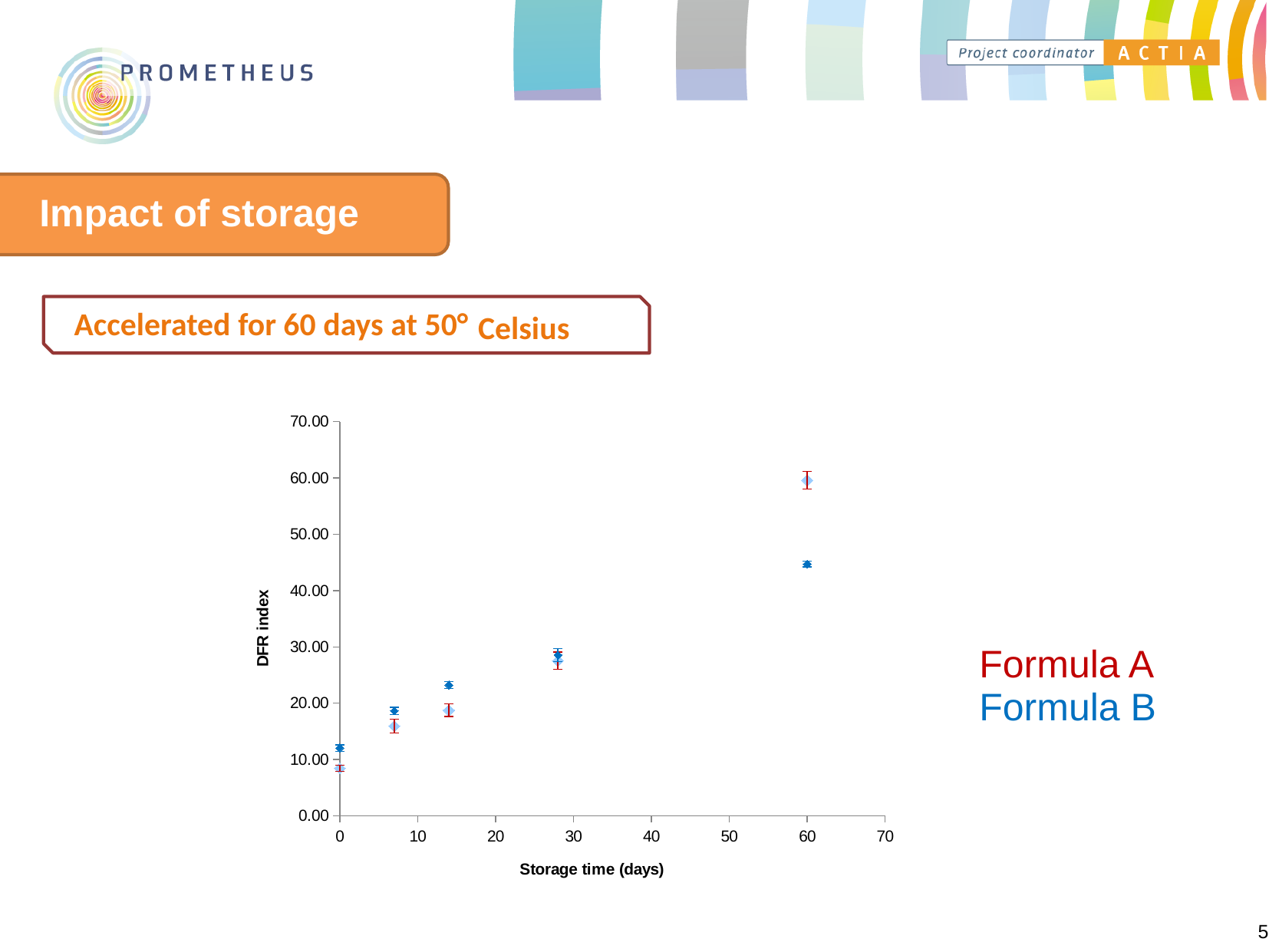
At 14 days, are both plotted DFR index values greater or less than 30.00? less What are the names of the two series in the legend? Formula A and Formula B Do the DFR index values rise or fall as storage time increases? rise At 60 days, is the lower of the two plotted DFR index values greater or less than 50.00? less At how many different storage times are points plotted? 5 What kind of chart is shown on the slide? scatter chart At which storage time are the plotted DFR index values highest? 60 days At 0 days, are both plotted DFR index values greater or less than 20.00? less What is the title of the y axis? DFR index How many series does the legend list? 2